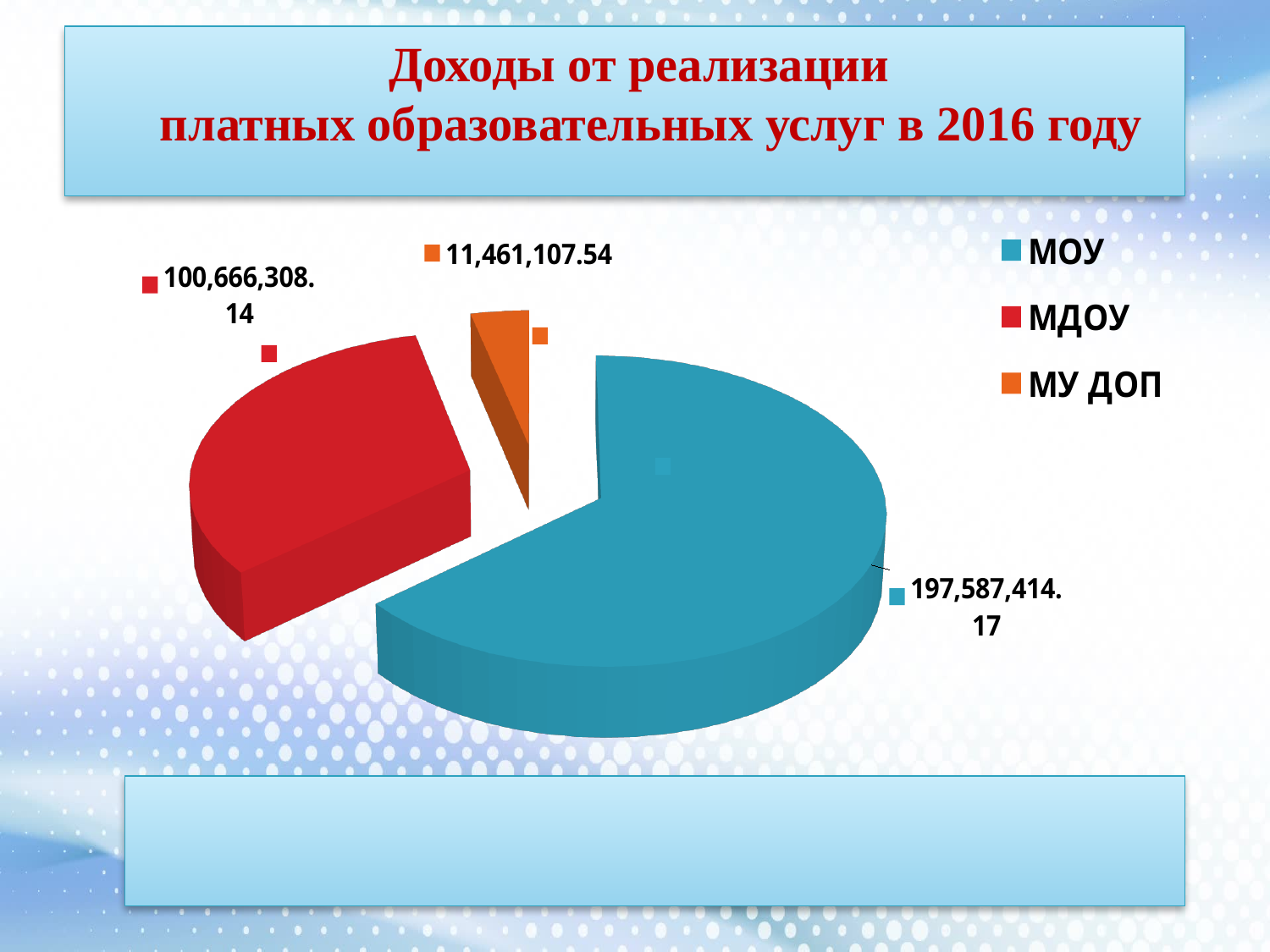
What is the difference between the values for МОУ and МДОУ? 96,921,106.03 How many entries does the legend list? 3 What is the difference between the values for МДОУ and МУ ДОП? 89,205,200.60 Which category has the largest slice of the pie? МОУ What is the value for МДОУ? 100,666,308.14 What colour is the slice for МУ ДОП? orange What is the value for МОУ? 197,587,414.17 Which is larger, the value for МДОУ or the value for МУ ДОП? МДОУ How many slices does the pie chart have? 3 Which category has the smallest slice of the pie? МУ ДОП What is the value for МУ ДОП? 11,461,107.54 What type of chart is shown on the slide? pie chart